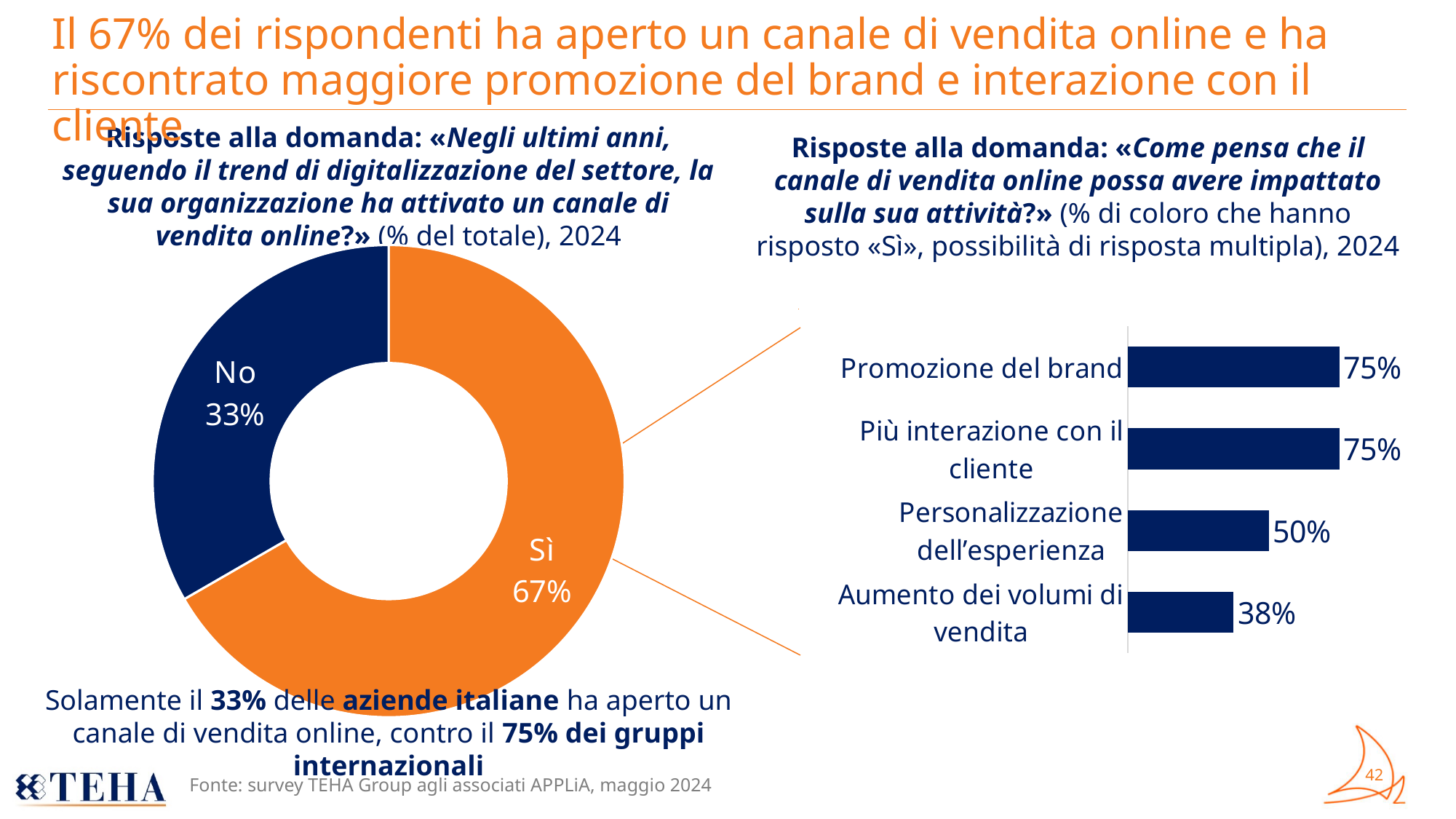
In the right chart, how many categories are shown? 4 In the right chart, which category has the lowest value? Aumento dei volumi di vendita In the left chart (donut), what percentage of respondents answered "Sì"? 67% In the left chart (donut), how many slices are shown? 2 In the right chart, what is the value for "Personalizzazione dell'esperienza"? 50% In the left chart (donut), what percentage of respondents answered "No"? 33% In the right chart, which is larger: "Personalizzazione dell'esperienza" or "Aumento dei volumi di vendita"? Personalizzazione dell'esperienza In the right chart, what is the difference between "Promozione del brand" and "Aumento dei volumi di vendita"? 37 percentage points In the left chart (donut), what is the difference between the "Sì" and "No" shares? 34 percentage points In the right chart, what is the value for "Aumento dei volumi di vendita"? 38% What kind of chart is the chart on the right of the slide? Bar chart What kind of chart is the chart on the left of the slide? Pie chart (donut)